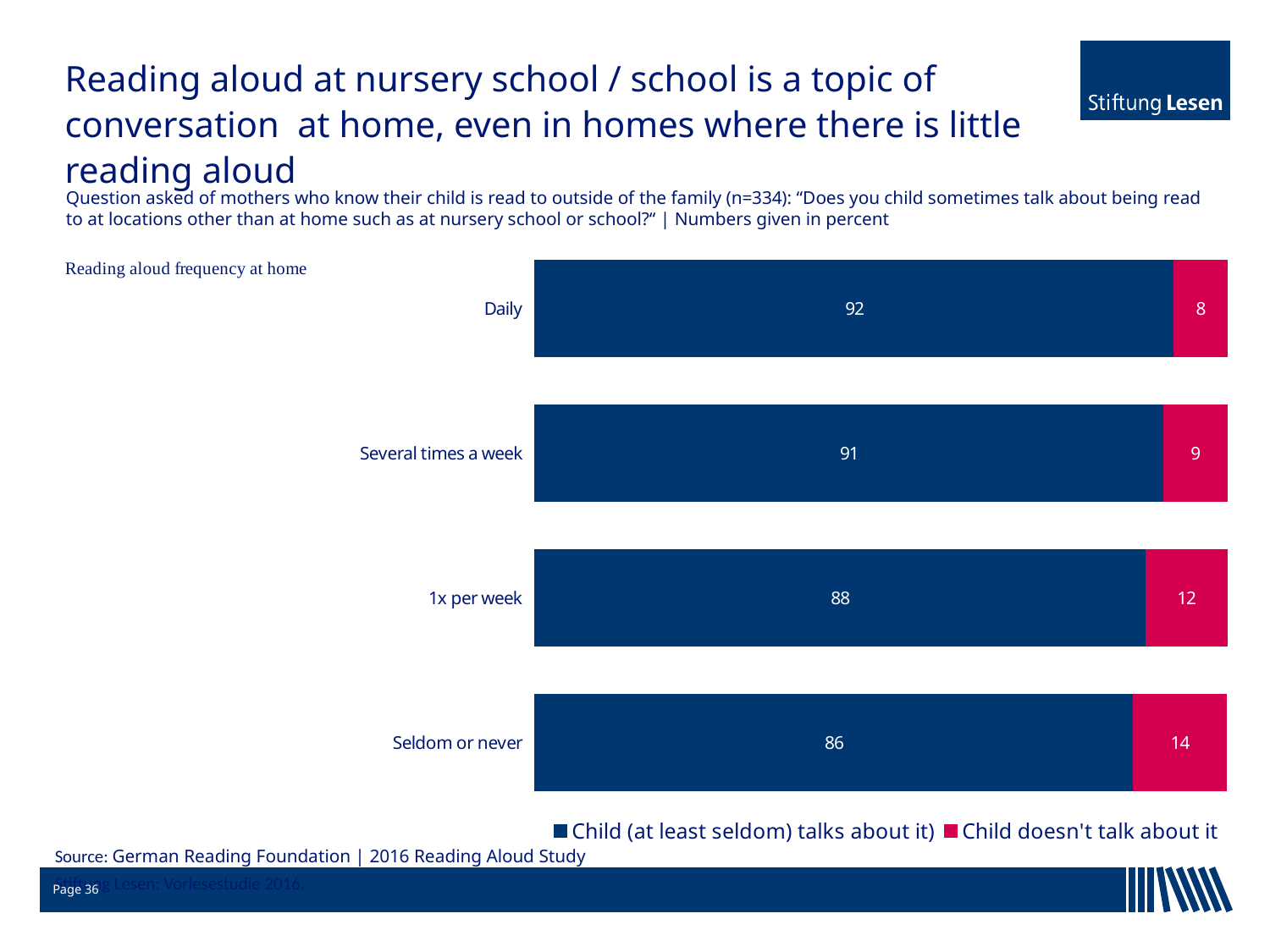
Which reading aloud frequency category has the lowest value for 'Child doesn't talk about it'? Daily What is the value for 'Child (at least seldom) talks about it' in the '1x per week' category? 88 What is the value for 'Child doesn't talk about it' in the 'Seldom or never' category? 14 Which colour represents 'Child doesn't talk about it' in the chart? Red What kind of chart is shown on the slide? Stacked bar chart How many series does the legend list? 2 What percentage of children in homes with daily reading aloud talk about being read to outside the home? 92 How many reading aloud frequency categories are shown in the chart? 4 What is the total of the stacked bar for 'Several times a week'? 100 Which is larger: the 'Child doesn't talk about it' value for '1x per week' or for 'Several times a week'? 1x per week Which reading aloud frequency category has the highest value for 'Child (at least seldom) talks about it'? Daily What is the difference between the 'Child (at least seldom) talks about it' values for 'Daily' and 'Seldom or never'? 6